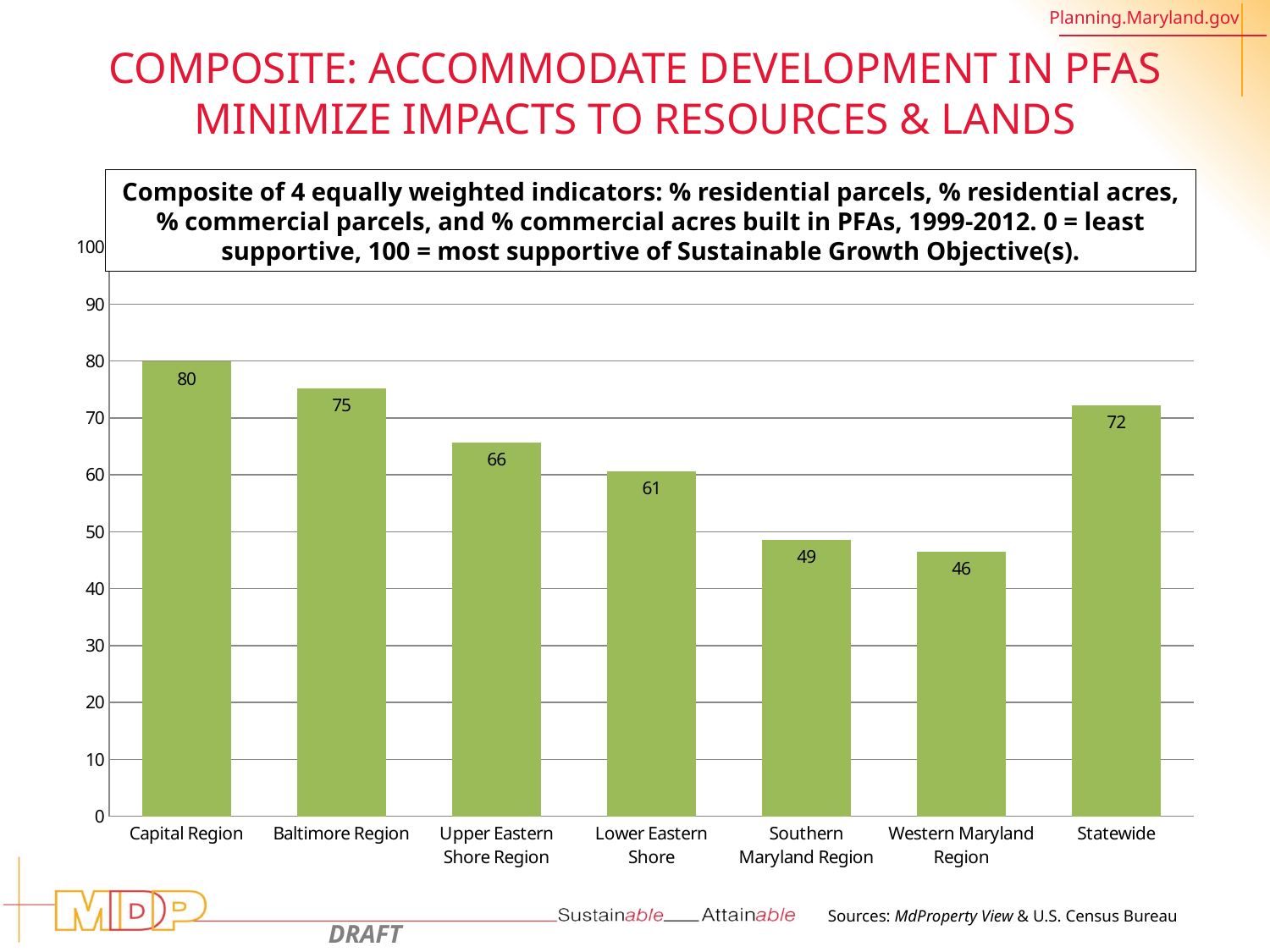
Is the value for Southern Maryland Region greater or less than 50? less What kind of chart is shown on the slide? bar chart What is the Statewide composite value? 72 Which region has the lowest composite value? Western Maryland Region How many categories are shown on the x axis? 7 What is the composite value for the Western Maryland Region? 46 Which is larger, the value for Upper Eastern Shore Region or Lower Eastern Shore? Upper Eastern Shore Region Which region has the highest composite value? Capital Region What is the composite value for the Capital Region? 80 What is the difference between the Capital Region and Baltimore Region values? 5 What is the maximum value shown on the y axis? 100 What is the difference between the Statewide value and the Southern Maryland Region value? 23